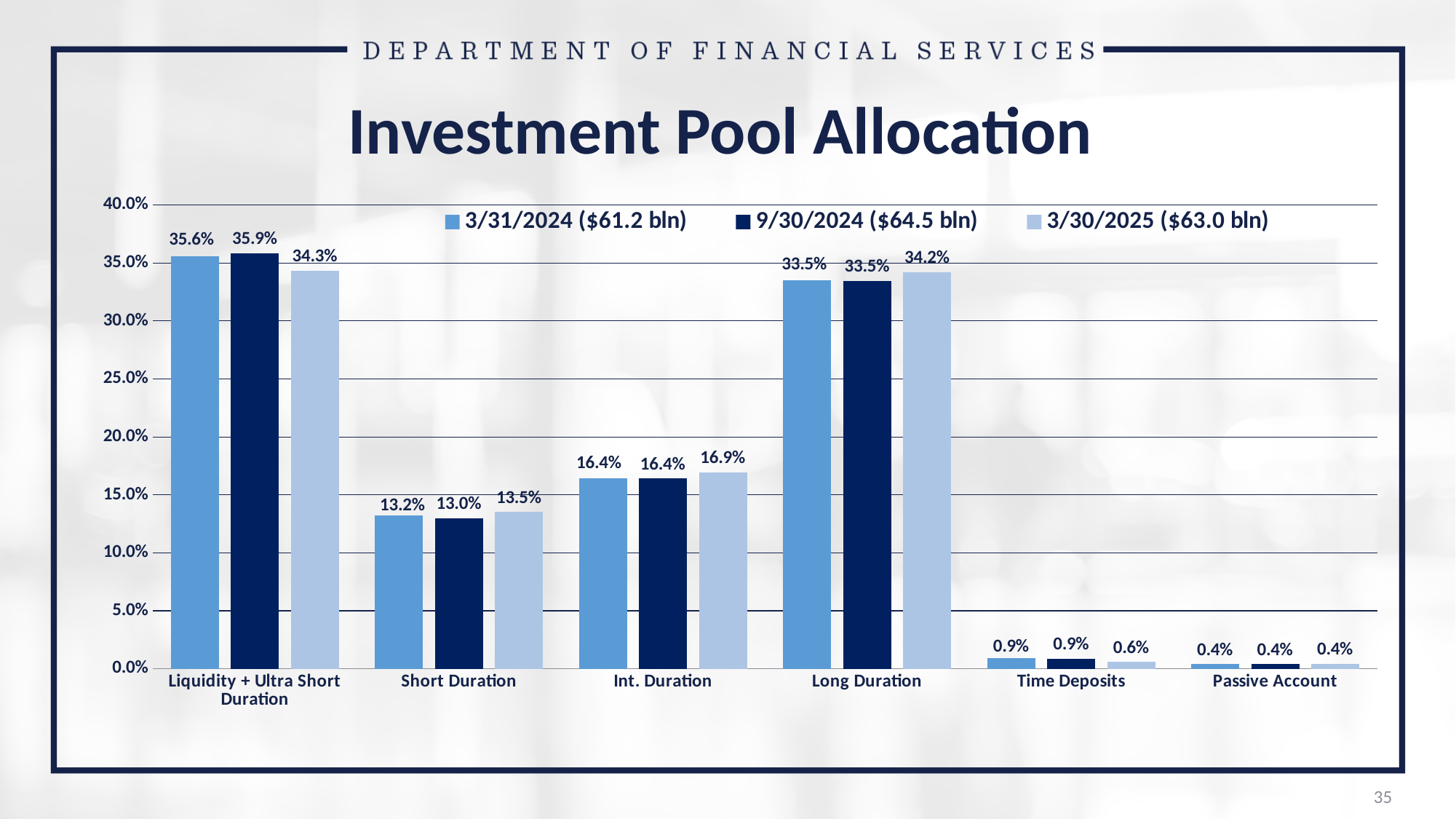
What kind of chart is shown on the slide? Bar chart How many categories are shown on the x axis? 6 Which is larger for Long Duration: the 3/31/2024 ($61.2 bln) value or the 3/30/2025 ($63.0 bln) value? 3/30/2025 ($63.0 bln) How many series does the legend list? 3 What is the value for Long Duration in the 3/30/2025 ($63.0 bln) series? 34.2% What is the value for Short Duration in the 9/30/2024 ($64.5 bln) series? 13.0% What is the difference between the 3/30/2025 ($63.0 bln) and 3/31/2024 ($61.2 bln) values for Int. Duration? 0.5% What is the title of the chart? Investment Pool Allocation Is the value for Short Duration in the 3/30/2025 ($63.0 bln) series greater or less than 15.0%? less Which category has the highest value in the 9/30/2024 ($64.5 bln) series? Liquidity + Ultra Short Duration Which category has the lowest value in the 3/31/2024 ($61.2 bln) series? Passive Account What is the value for Liquidity + Ultra Short Duration in the 3/31/2024 ($61.2 bln) series? 35.6%